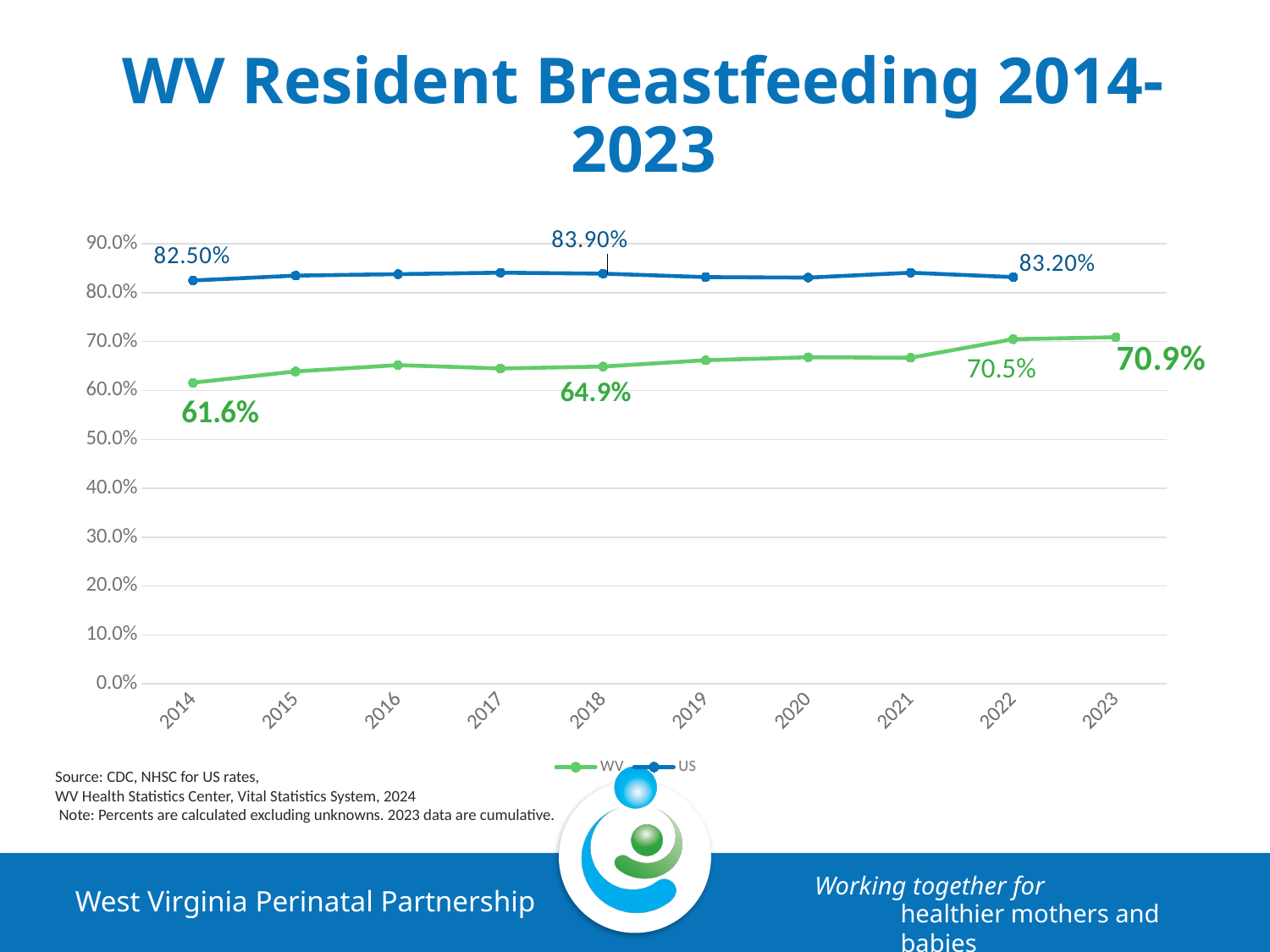
What is the WV breastfeeding rate in 2023? 70.9% What kind of chart is shown on the slide? Line chart What is the difference between the US and WV breastfeeding rates in 2014? 20.9 percentage points What is the US breastfeeding rate in 2022? 83.20% Is the WV value for 2020 greater or less than 60.0%? greater What is the WV breastfeeding rate in 2022? 70.5% Which series has the higher value in 2018, WV or US? US What is the WV breastfeeding rate in 2014? 61.6% How many series does the legend list? 2 By how much did the WV breastfeeding rate increase from 2014 to 2023? 9.3 percentage points What is the US breastfeeding rate in 2018? 83.90% What is the US breastfeeding rate in 2014? 82.50%